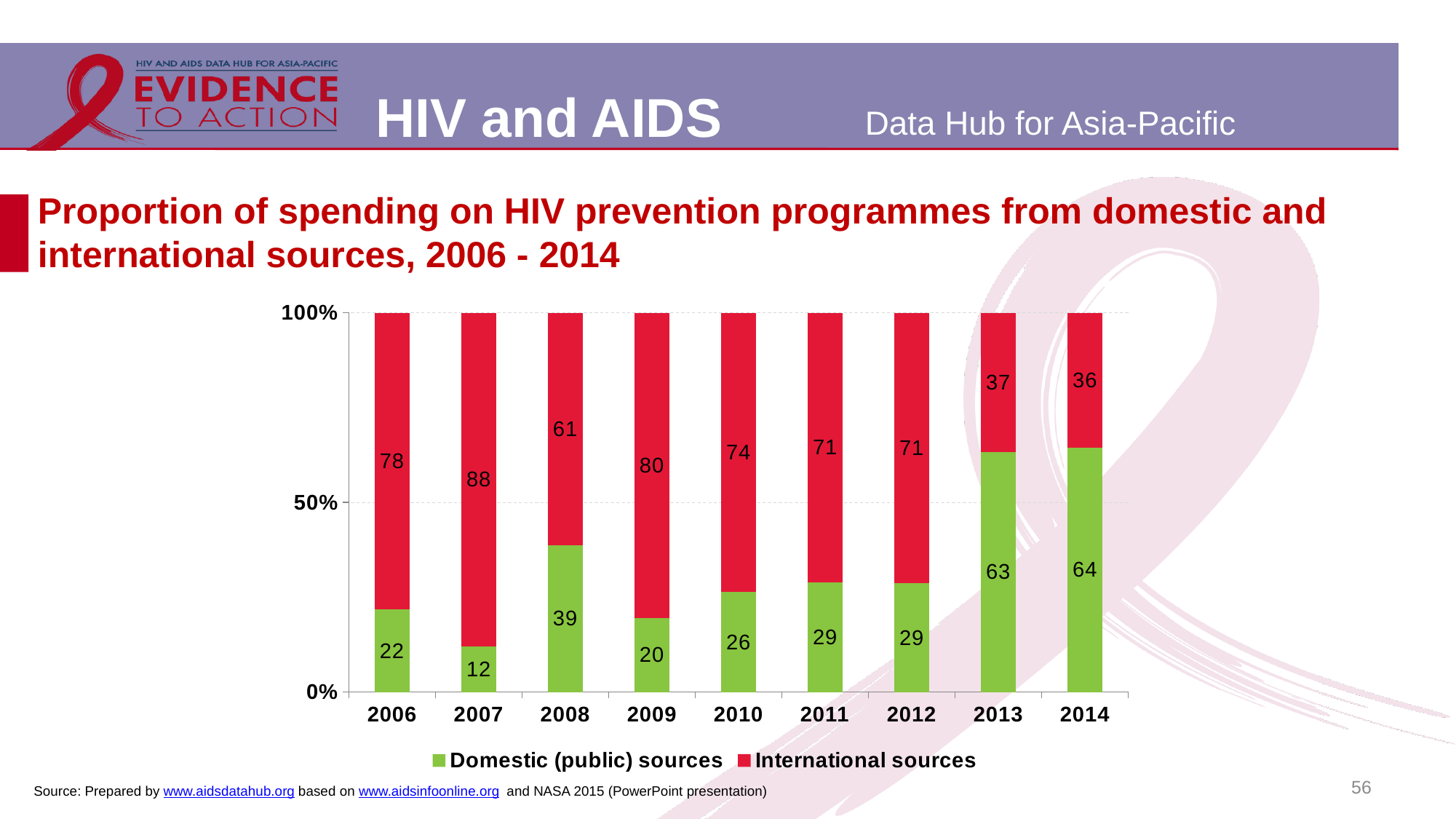
What is the value for Domestic (public) sources in 2014? 64 Which year has the highest value for Domestic (public) sources? 2014 What is the value for Domestic (public) sources in 2008? 39 What kind of chart is shown on the slide? Stacked bar chart Which colour represents International sources in the chart? Red How many years are shown on the x axis? 9 How many series does the legend list? 2 Which year has the highest value for International sources? 2007 What is the difference between the Domestic (public) sources values for 2013 and 2012? 34 Which is larger: the International sources value for 2009 or for 2010? 2009 Which year has the lowest value for Domestic (public) sources? 2007 What is the value for International sources in 2007? 88